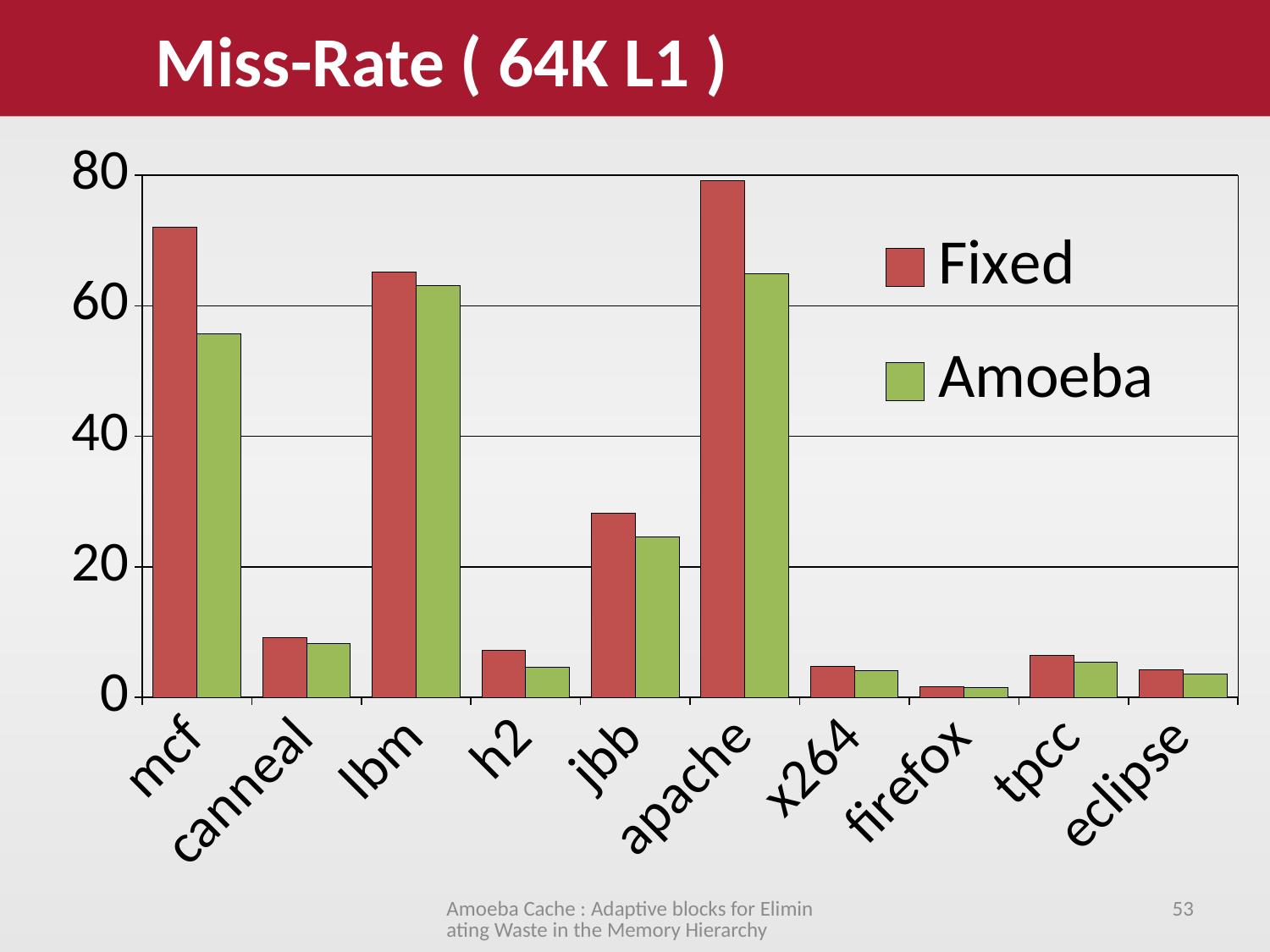
Which is larger, the Fixed value for mcf or the Fixed value for lbm? mcf Is the Amoeba value for mcf greater or less than 60? less Is the Fixed value for jbb greater or less than 20? greater Which category has the lowest Fixed value? firefox How many series does the legend list? 2 How many categories are shown on the x axis? 10 Which category has the lowest Amoeba value? firefox For apache, which series has the larger value, Fixed or Amoeba? Fixed Is the Fixed value for canneal greater or less than 20? less What kind of chart is shown on the slide? bar chart Which category has the highest Fixed value? apache